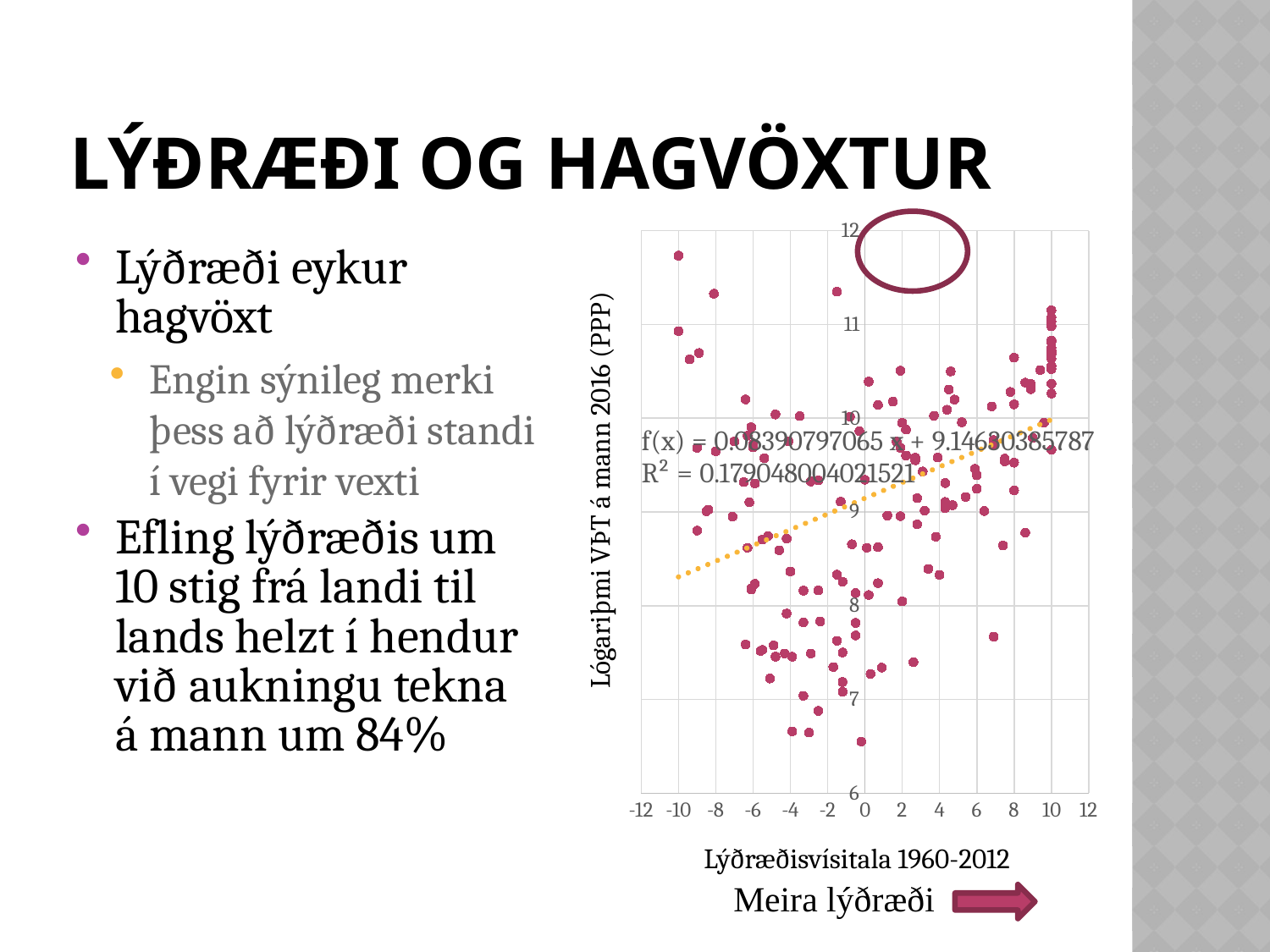
Is the y value of the trendline at x = 10 greater or less than 9? greater What is the title of the x axis of the chart? Lýðræðisvísitala 1960-2012 Does the dotted trendline in the scatter plot rise or fall as the democracy index increases along the x axis? rise What is the lowest value shown on the y axis of the chart? 6 Is the y value of the highest point in the scatter plot greater or less than 11? greater What is the highest value shown on the y axis of the chart? 12 What is the title of the y axis of the chart? Lógariþmi VÞT á mann 2016 (PPP) What is the lowest value shown on the x axis of the chart? -12 What kind of chart is shown on the slide? scatter plot Is the y value of the lowest point in the scatter plot greater or less than 7? less What is the R² value printed on the chart? 0.179048004021521 What is the highest value shown on the x axis of the chart? 12